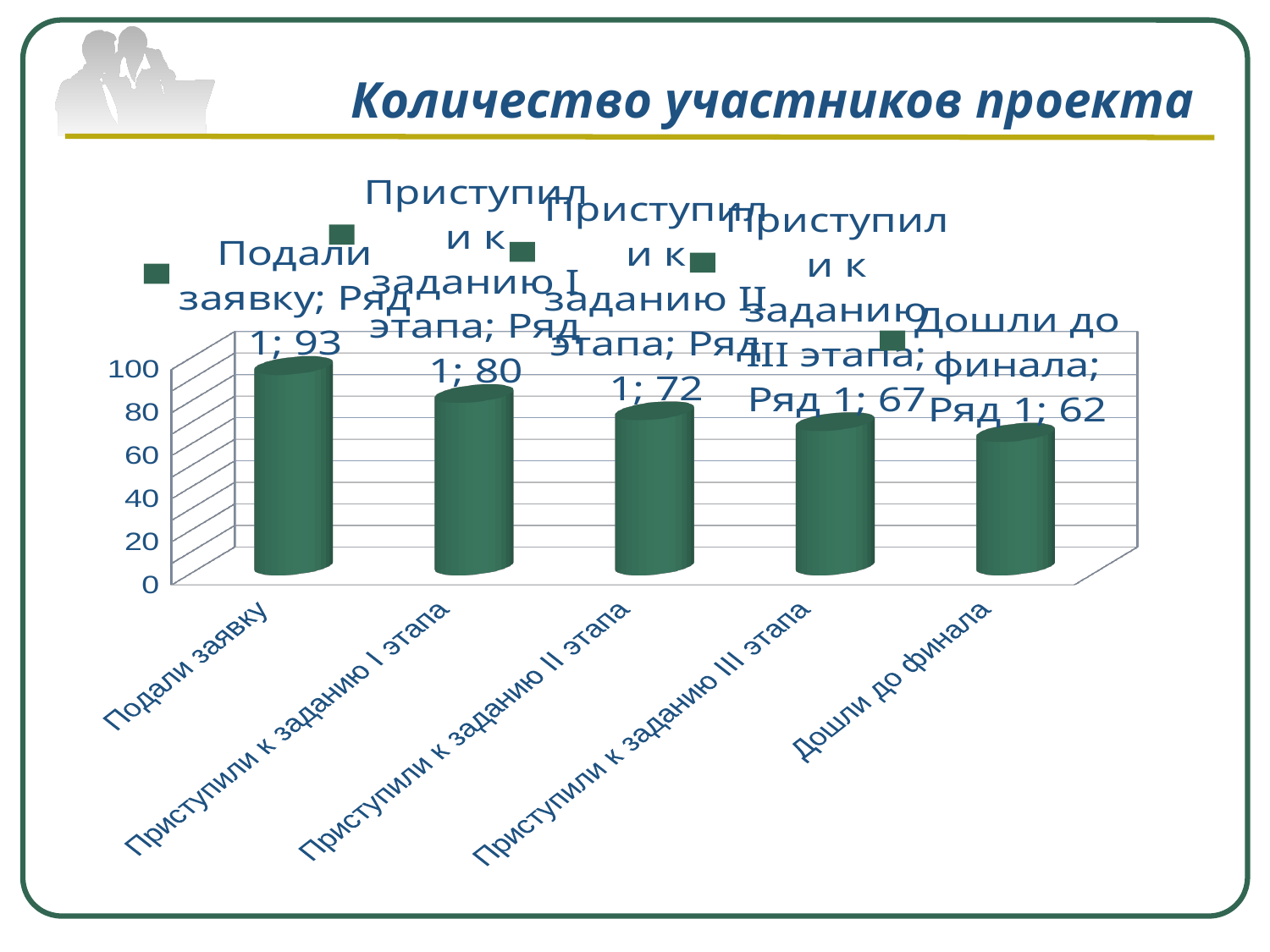
Which category has the highest value? Подали заявку Which category has the lowest value? Дошли до финала Which is larger: the value for "Приступили к заданию I этапа" or "Приступили к заданию III этапа"? Приступили к заданию I этапа What is the value for "Приступили к заданию III этапа"? 67 Do the values rise or fall from left to right along the x axis? Fall What is the value for "Дошли до финала"? 62 What is the value for "Подали заявку"? 93 What is the difference between the values for "Подали заявку" and "Дошли до финала"? 31 What kind of chart is shown on the slide? Bar chart How many categories are shown on the chart? 5 What is the value for "Приступили к заданию II этапа"? 72 What is the value for "Приступили к заданию I этапа"? 80